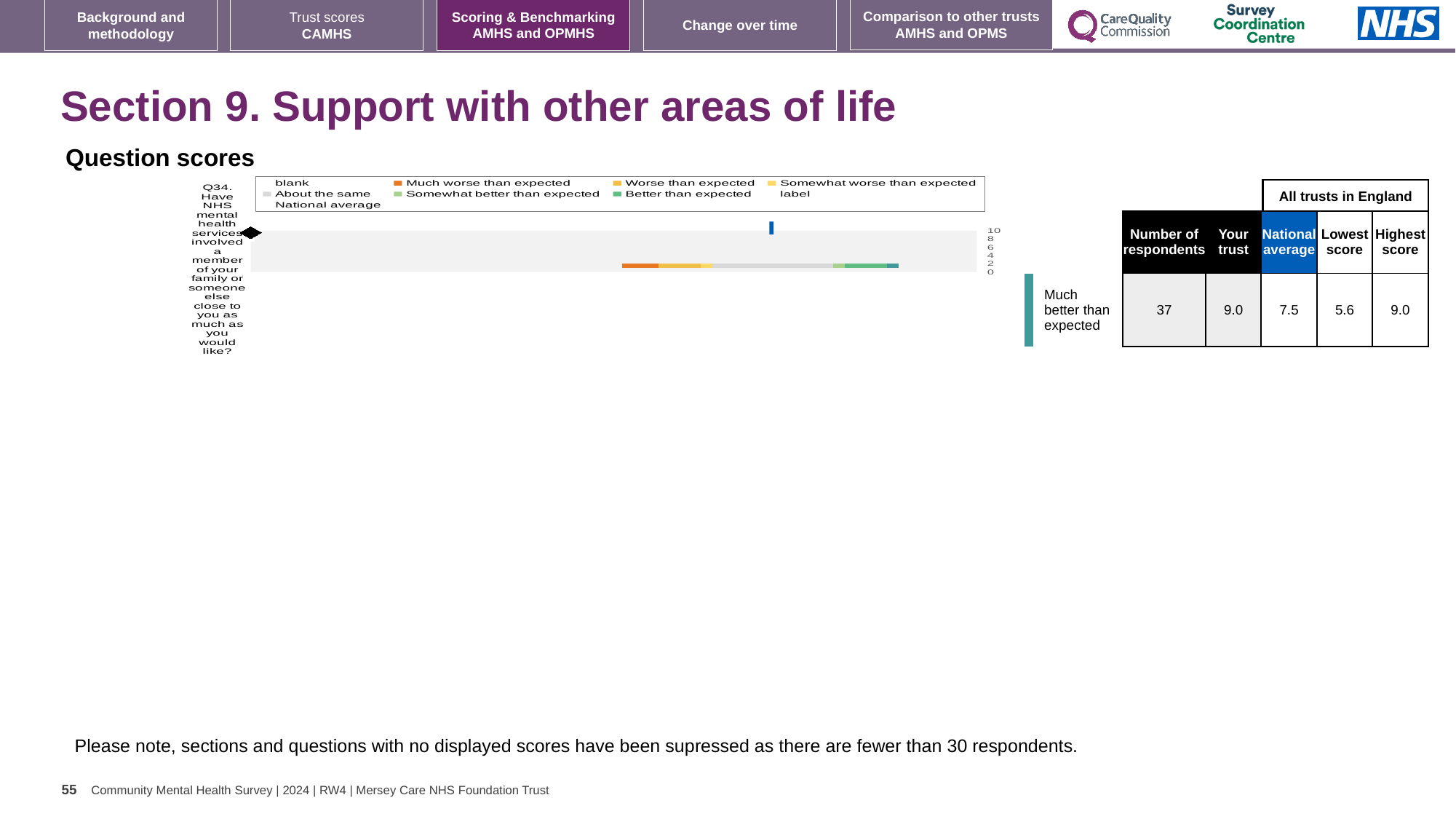
In the table beside the Question scores chart, what is the lowest score among all trusts in England for Q34? 5.6 For Q34, which is larger: the 'Your trust' score or the national average? Your trust Which question number is plotted in the Question scores chart? Q34 In the table beside the Question scores chart, what is the 'Your trust' score for Q34? 9.0 What kind of chart is shown under 'Question scores'? bar chart For Q34, what is the difference between the 'Your trust' score and the national average? 1.5 In the table beside the Question scores chart, what is the national average score for Q34? 7.5 How many questions are plotted in the Question scores chart? 1 What is the highest value shown on the axis of the Question scores chart? 10 In the table beside the Question scores chart, what is the number of respondents for Q34? 37 How many entries does the legend of the Question scores chart list? 9 In the table beside the Question scores chart, what is the highest score among all trusts in England for Q34? 9.0